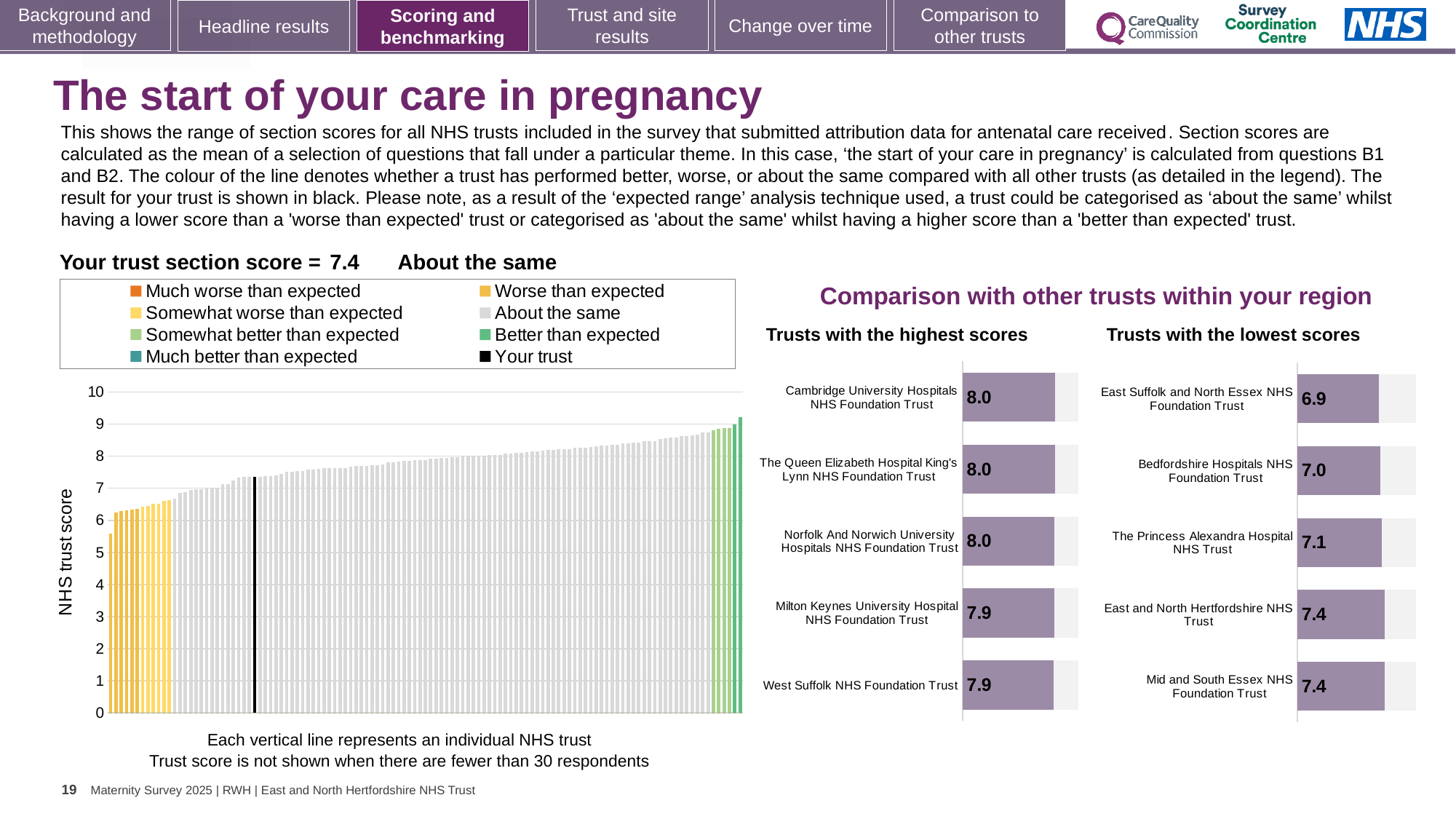
In the 'Trusts with the highest scores' chart, what is the score for Milton Keynes University Hospital NHS Foundation Trust? 7.9 In the large chart on the left, is the value of the black bar (your trust) greater or less than 7? greater In the large chart on the left, do the trust scores rise or fall from left to right? Rise In the 'Trusts with the lowest scores' chart, which trust has the lowest score? East Suffolk and North Essex NHS Foundation Trust What is the y-axis label of the large chart on the left? NHS trust score How many trusts are shown in the 'Trusts with the highest scores' chart? 5 What kind of chart is the large chart on the left showing NHS trust scores? Bar chart In the 'Trusts with the highest scores' chart, what is the difference between the scores of Cambridge University Hospitals NHS Foundation Trust and West Suffolk NHS Foundation Trust? 0.1 In the 'Trusts with the lowest scores' chart, which has the larger score: Bedfordshire Hospitals NHS Foundation Trust or The Princess Alexandra Hospital NHS Trust? The Princess Alexandra Hospital NHS Trust How many entries does the legend above the large chart on the left list? 8 In the 'Trusts with the lowest scores' chart, what is the difference between the scores of East and North Hertfordshire NHS Trust and East Suffolk and North Essex NHS Foundation Trust? 0.5 What is the section score for your trust shown on the slide? 7.4